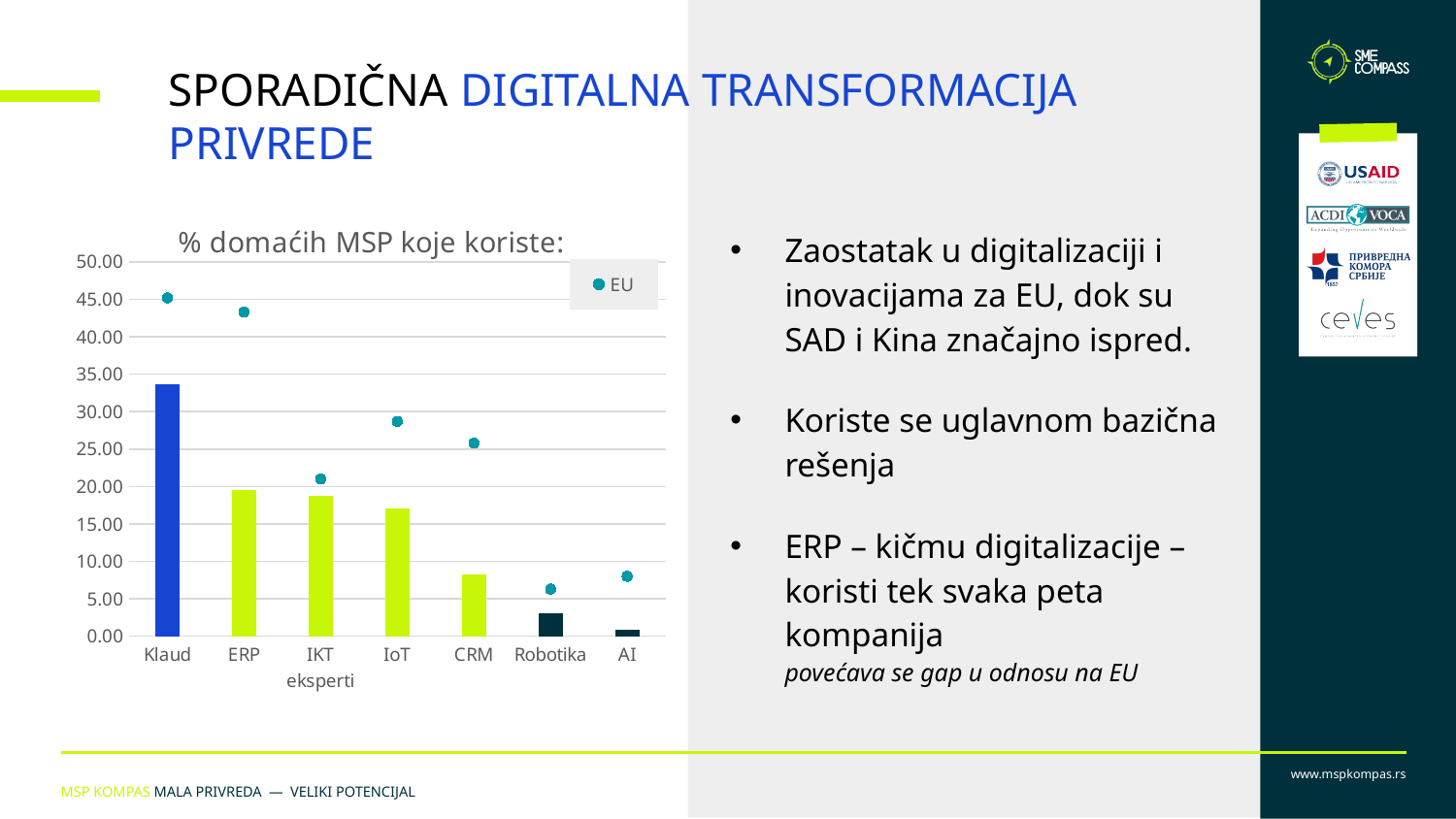
Which category has the tallest bar in the chart? Klaud What is the title of the chart? % domaćih MSP koje koriste: How many series does the chart's legend list? 1 Is the EU marker value for AI greater or less than 10.00? less Which category has the shortest bar in the chart? AI How many categories are shown on the x axis of the chart? 7 Is the bar value for Klaud greater or less than 30.00? greater Which has the higher EU marker value, ERP or IoT? ERP Is the bar value for CRM greater or less than 10.00? less Do the bar values rise or fall moving from Klaud to AI along the x axis? fall What kind of chart is shown on the slide? bar chart